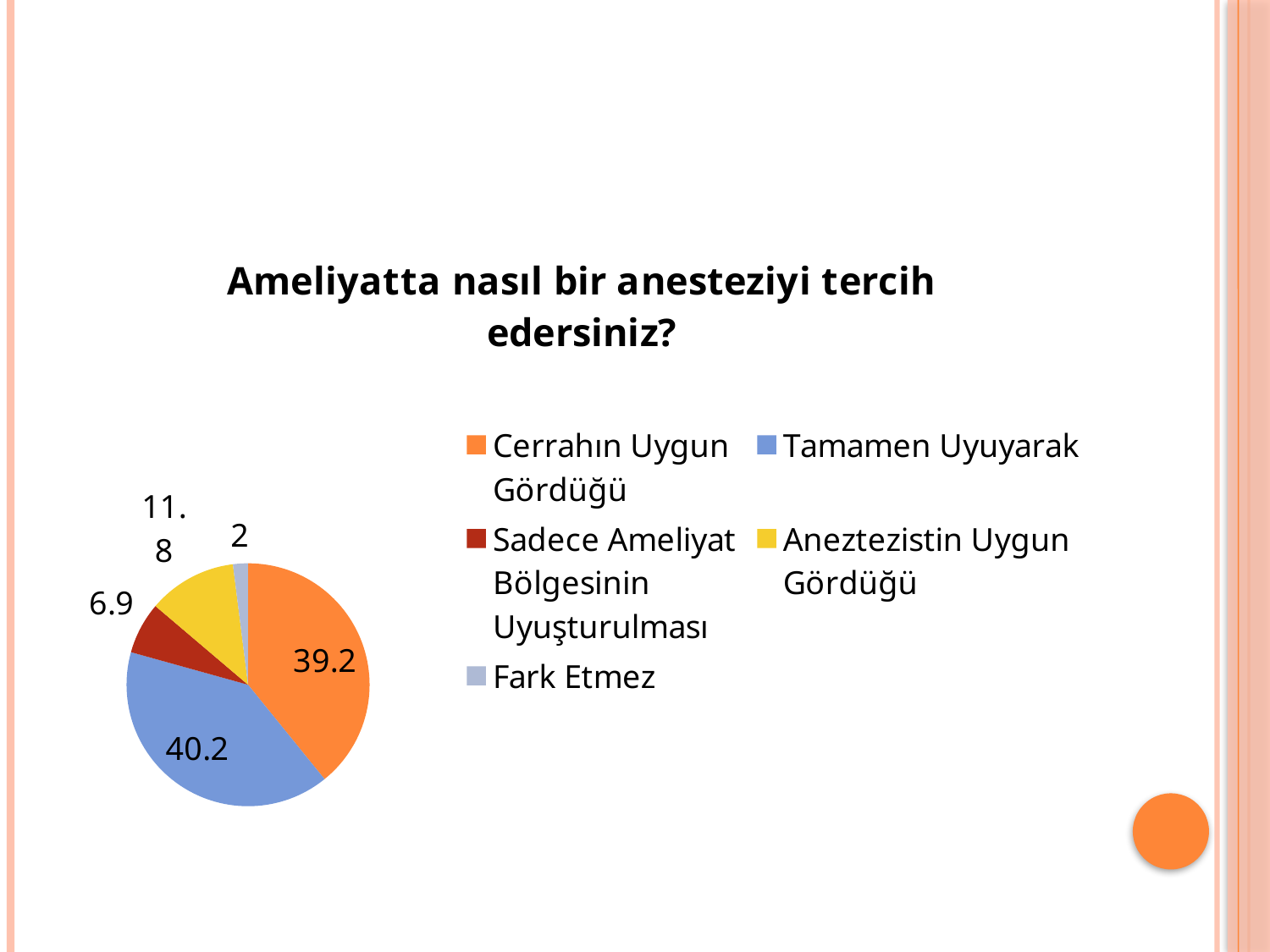
What kind of chart is shown on the slide? pie chart What is the value for Sadece Ameliyat Bölgesinin Uyuşturulması? 6.9 What is the value for Cerrahın Uygun Gördüğü? 39.2 Which category has the smallest slice? Fark Etmez What is the value for Fark Etmez? 2 What is the title of the chart? Ameliyatta nasıl bir anesteziyi tercih edersiniz? Which category has the largest slice? Tamamen Uyuyarak What is the value for Tamamen Uyuyarak? 40.2 What is the value for Aneztezistin Uygun Gördüğü? 11.8 Which is larger, the value for Aneztezistin Uygun Gördüğü or the value for Sadece Ameliyat Bölgesinin Uyuşturulması? Aneztezistin Uygun Gördüğü How many categories does the legend list? 5 What is the difference between the values for Tamamen Uyuyarak and Cerrahın Uygun Gördüğü? 1